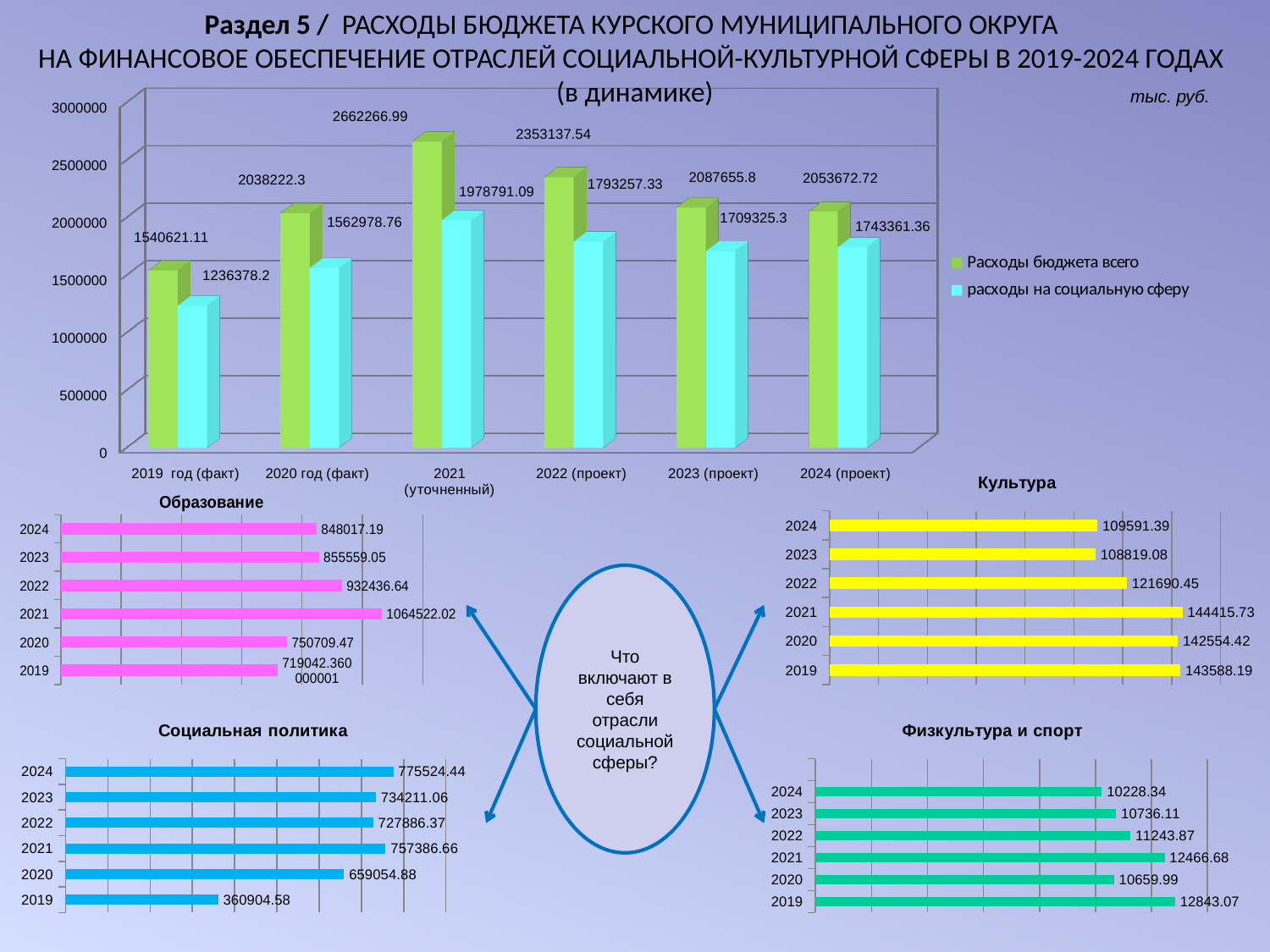
In the top chart, which year has the lowest value for 'расходы на социальную сферу'? 2019 год (факт) In the 'Социальная политика' chart, what is the value for 2019? 360904.58 In the 'Культура' chart, which year has the lowest value? 2023 In the top chart, what is the value of 'Расходы бюджета всего' for 2021 (уточненный)? 2662266.99 In the top chart, which year has the highest value for 'Расходы бюджета всего'? 2021 (уточненный) In the top chart, what is the difference between 'Расходы бюджета всего' and 'расходы на социальную сферу' for 2024 (проект)? 310311.36 In the 'Образование' chart, what is the value for 2021? 1064522.02 In the top chart, what is the value of 'расходы на социальную сферу' for 2019 год (факт)? 1236378.2 What kind of chart is the 'Культура' chart? Bar chart In the 'Социальная политика' chart, which is larger: the value for 2024 or the value for 2021? 2024 In the 'Физкультура и спорт' chart, which year has the highest value? 2019 How many series does the legend of the top chart list? 2